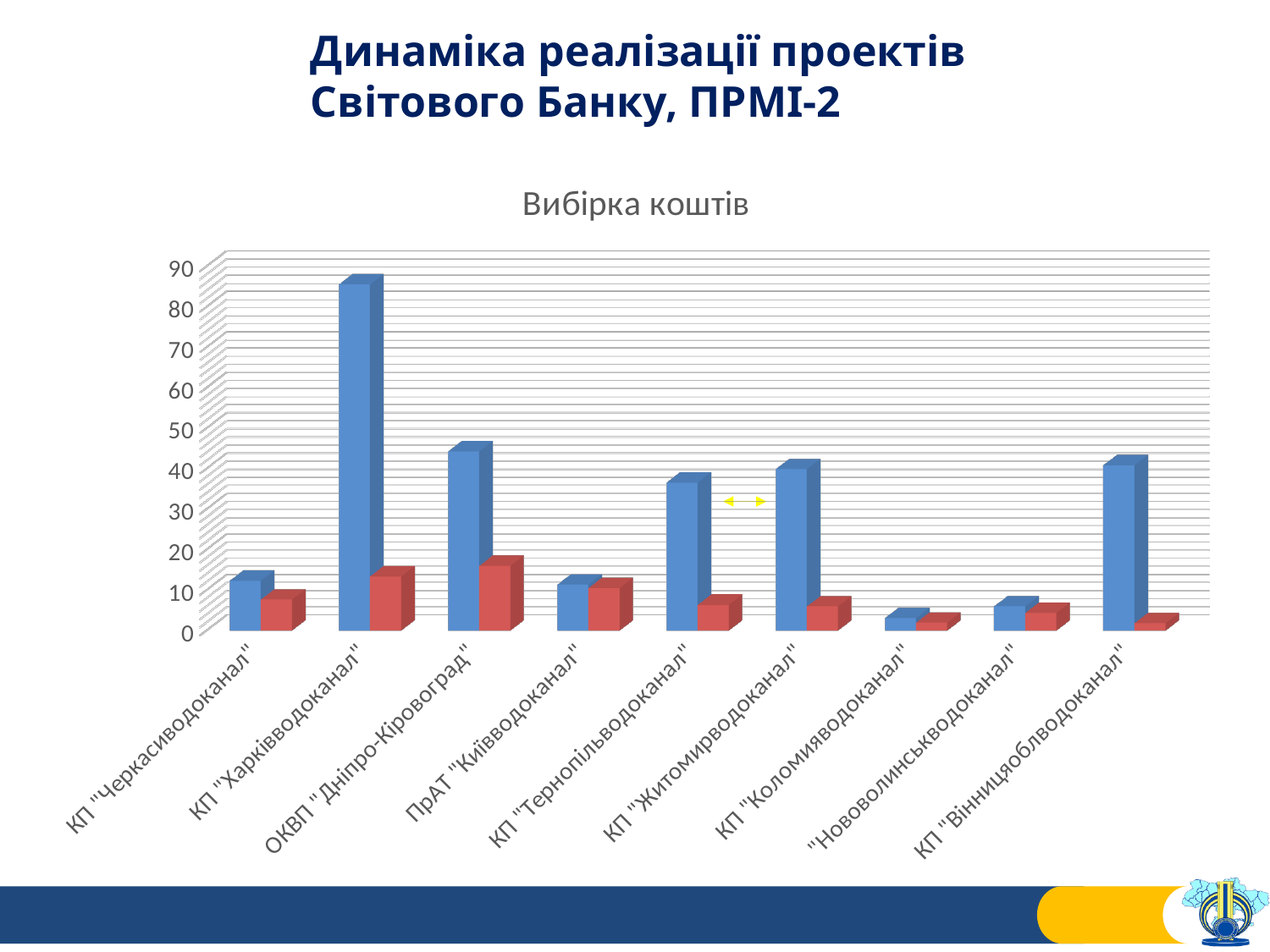
What is the highest value shown on the vertical axis? 90 Which is larger, the blue bar for КП "Житомирводоканал" or the blue bar for КП "Черкасиводоканал"? КП "Житомирводоканал" Which category has the tallest blue bar? КП "Харківводоканал" Is the blue bar for КП "Харківводоканал" greater or less than 80? greater Is the red bar for ОКВП "Дніпро-Кіровоград" greater or less than 20? less What kind of chart is shown on the slide? bar chart Which category has the tallest red bar? ОКВП "Дніпро-Кіровоград" How many categories are shown on the x axis of the chart? 9 Is the blue bar for КП "Тернопільводоканал" greater or less than 40? less Which category has the shortest blue bar? КП "Коломияводоканал" What is the title of the chart? Вибірка коштів